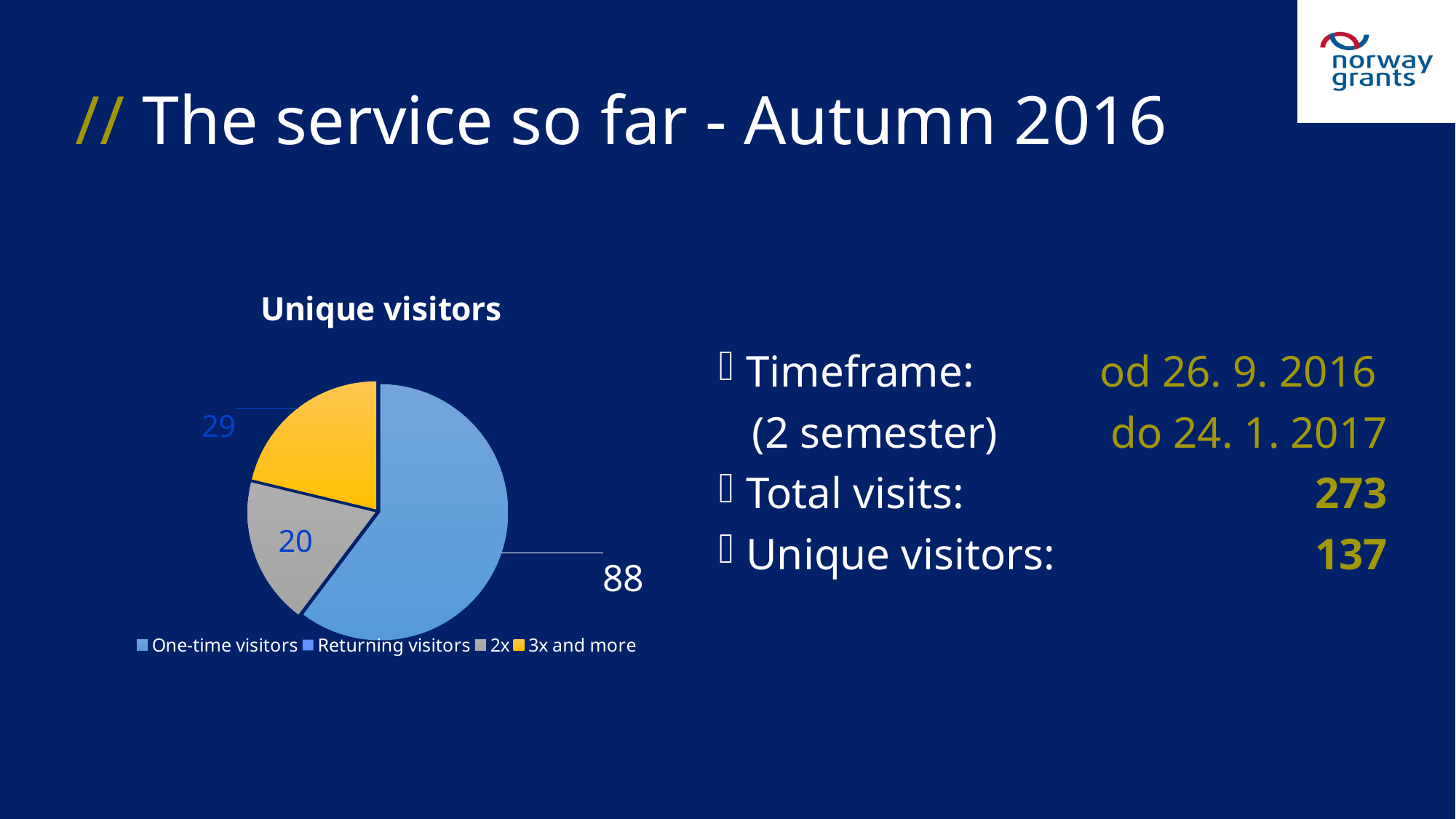
What is the value for One-time visitors in the pie chart? 88 How many entries does the chart legend list? 4 What is the value for the 2x slice in the pie chart? 20 How many slices in the pie chart have a data label? 3 What is the difference between the 3x and more value and the 2x value? 9 Which slice of the pie chart is the largest? One-time visitors What is the title of the chart? Unique visitors What is the difference between the One-time visitors value and the 3x and more value? 59 Which is larger, the 2x slice or the 3x and more slice? 3x and more What kind of chart is shown on the slide? pie chart What is the value for the 3x and more slice in the pie chart? 29 Which labelled slice of the pie chart is the smallest? 2x